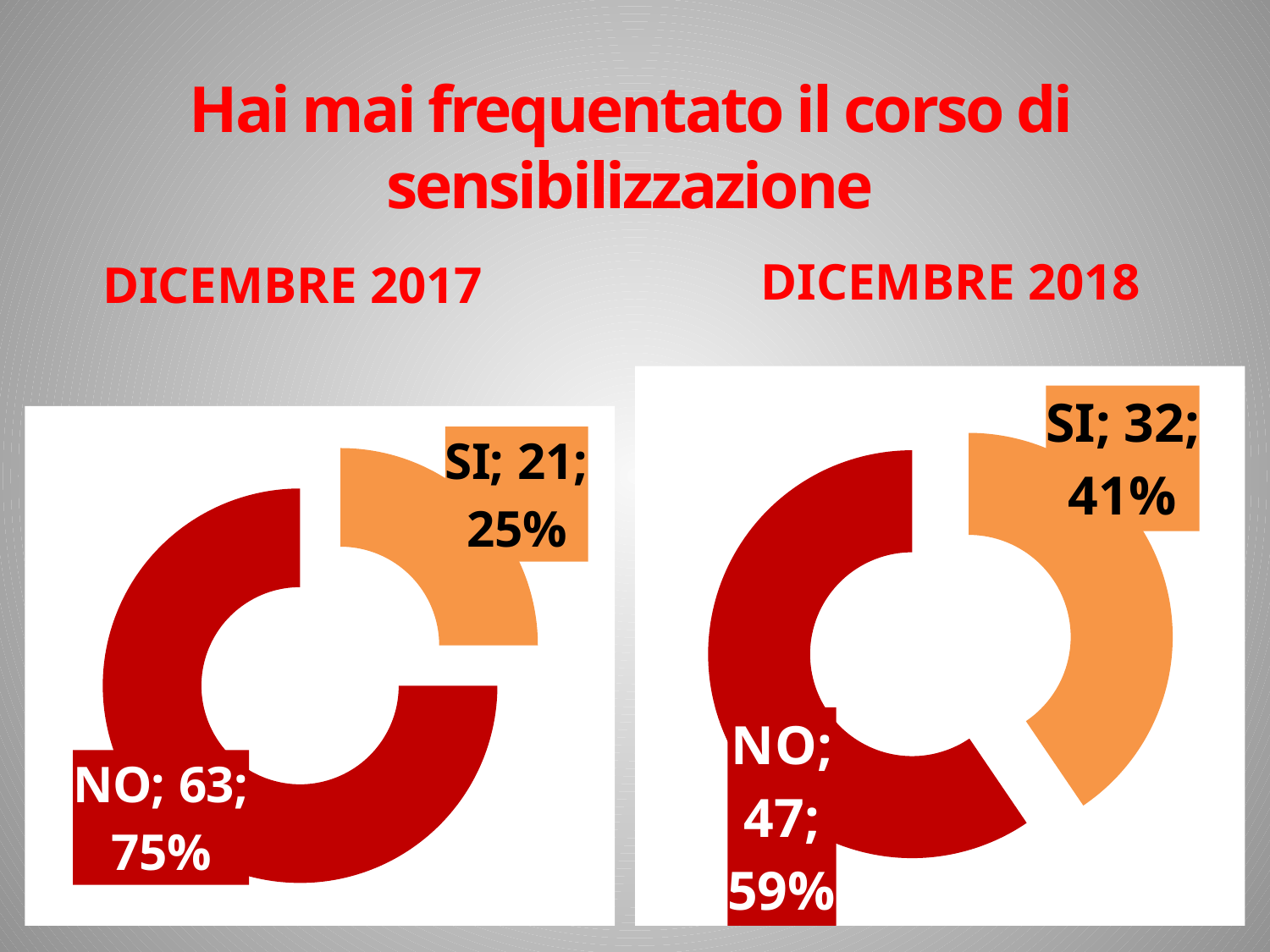
In the DICEMBRE 2017 chart, which answer has the largest share? NO In the DICEMBRE 2017 chart, how many respondents answered NO? 63 In the DICEMBRE 2018 chart, what percentage answered NO? 59% In the DICEMBRE 2018 chart, how many respondents answered SI? 32 What kind of chart is the DICEMBRE 2017 chart? Doughnut chart In the DICEMBRE 2018 chart, what is the difference between the NO count and the SI count? 15 In the DICEMBRE 2018 chart, which answer has the smallest share? SI In the DICEMBRE 2017 chart, what is the difference between the NO count and the SI count? 42 Is the SI count larger in the DICEMBRE 2017 chart or the DICEMBRE 2018 chart? DICEMBRE 2018 In the DICEMBRE 2017 chart, what percentage answered SI? 25% How many categories does the DICEMBRE 2018 chart show? 2 What is the total number of respondents in the DICEMBRE 2017 chart? 84